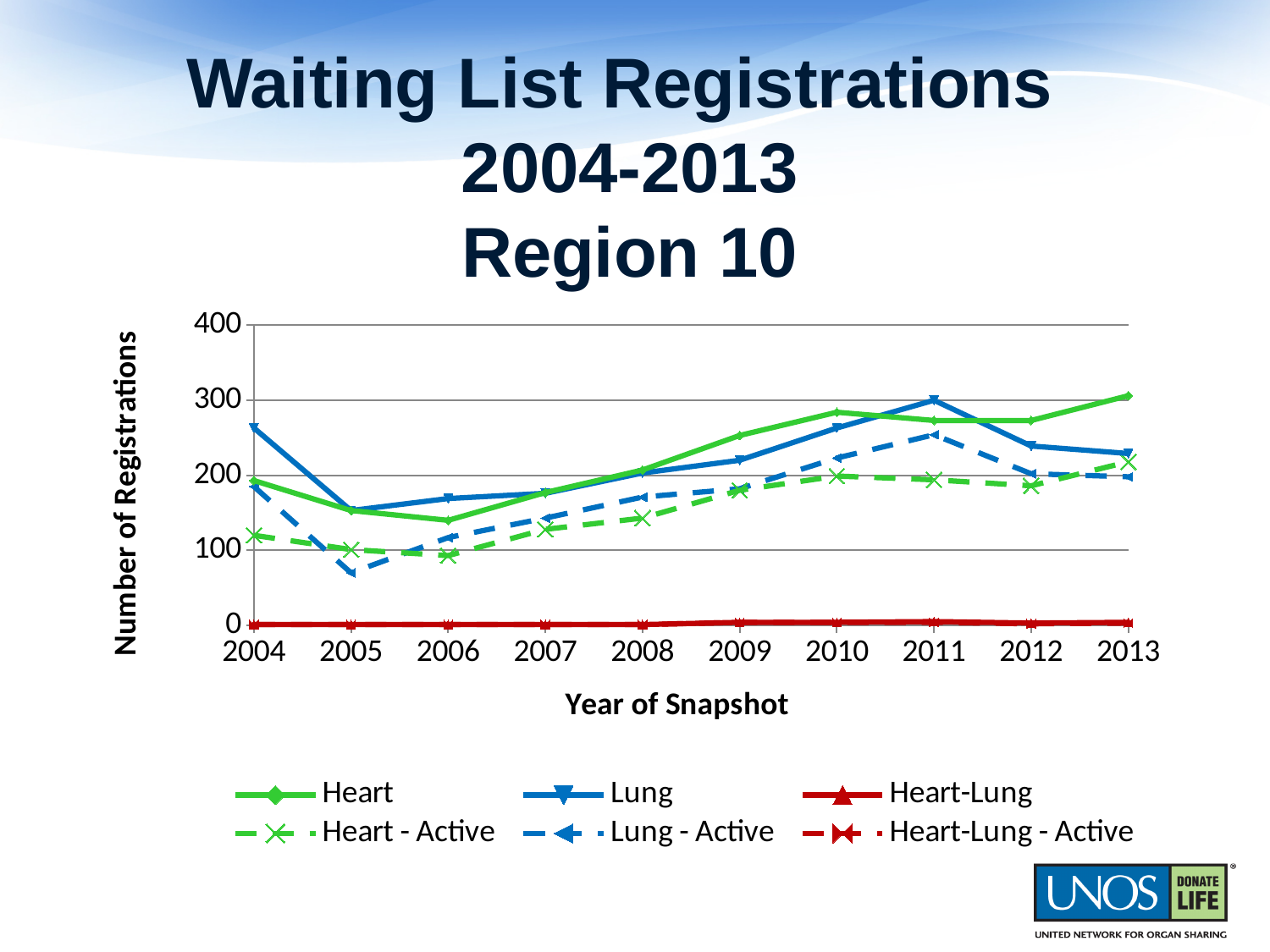
In 2004, which is larger, the Heart value or the Lung value? Lung In 2013, which is larger, the Heart value or the Lung value? Heart What is the title of the x axis? Year of Snapshot Does the Heart series rise or fall from 2006 to 2010? rise In which year does the Lung series reach its highest value? 2011 Is the Lung - Active value for 2005 greater or less than 100? less In which year does the Lung - Active series reach its lowest value? 2005 How many series does the legend list? 6 Is the Heart value for 2010 greater or less than 200? greater Is the Lung value for 2004 greater or less than 200? greater What kind of chart is shown on the slide? line chart How many years are plotted along the x axis? 10